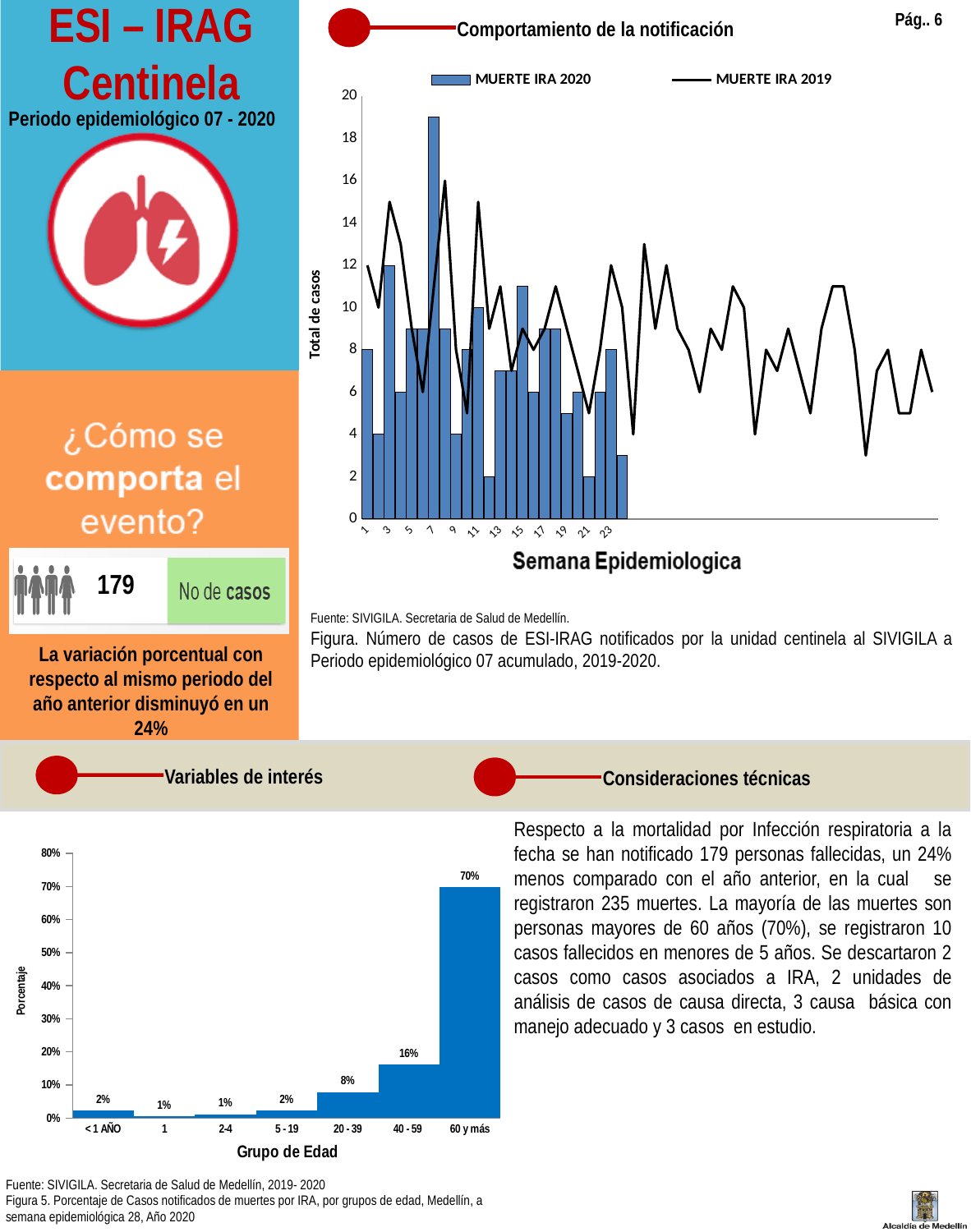
In the top chart 'Comportamiento de la notificación', is the MUERTE IRA 2020 bar for week 7 greater or less than 16? greater In the bottom chart by age group, what is the difference in percentage points between the '60 y más' group and the '40 - 59' group? 54 How many age groups are shown on the x axis of the bottom chart? 7 What is the label of the x axis of the bottom chart? Grupo de Edad In the bottom chart by age group, which is larger: the value for '< 1 AÑO' or the value for '2-4'? < 1 AÑO In the bottom chart by age group, what percentage is shown for the '20 - 39' group? 8% What is the y-axis label of the top chart 'Comportamiento de la notificación'? Total de casos In the bottom chart by age group, which age group has the highest percentage? 60 y más How many series does the legend of the top chart 'Comportamiento de la notificación' list? 2 In the bottom chart by age group, what percentage is shown for the '60 y más' group? 70% In the top chart 'Comportamiento de la notificación', is the MUERTE IRA 2020 bar for week 23 greater or less than 6? greater In the bottom chart by age group, what percentage is shown for the '40 - 59' group? 16%